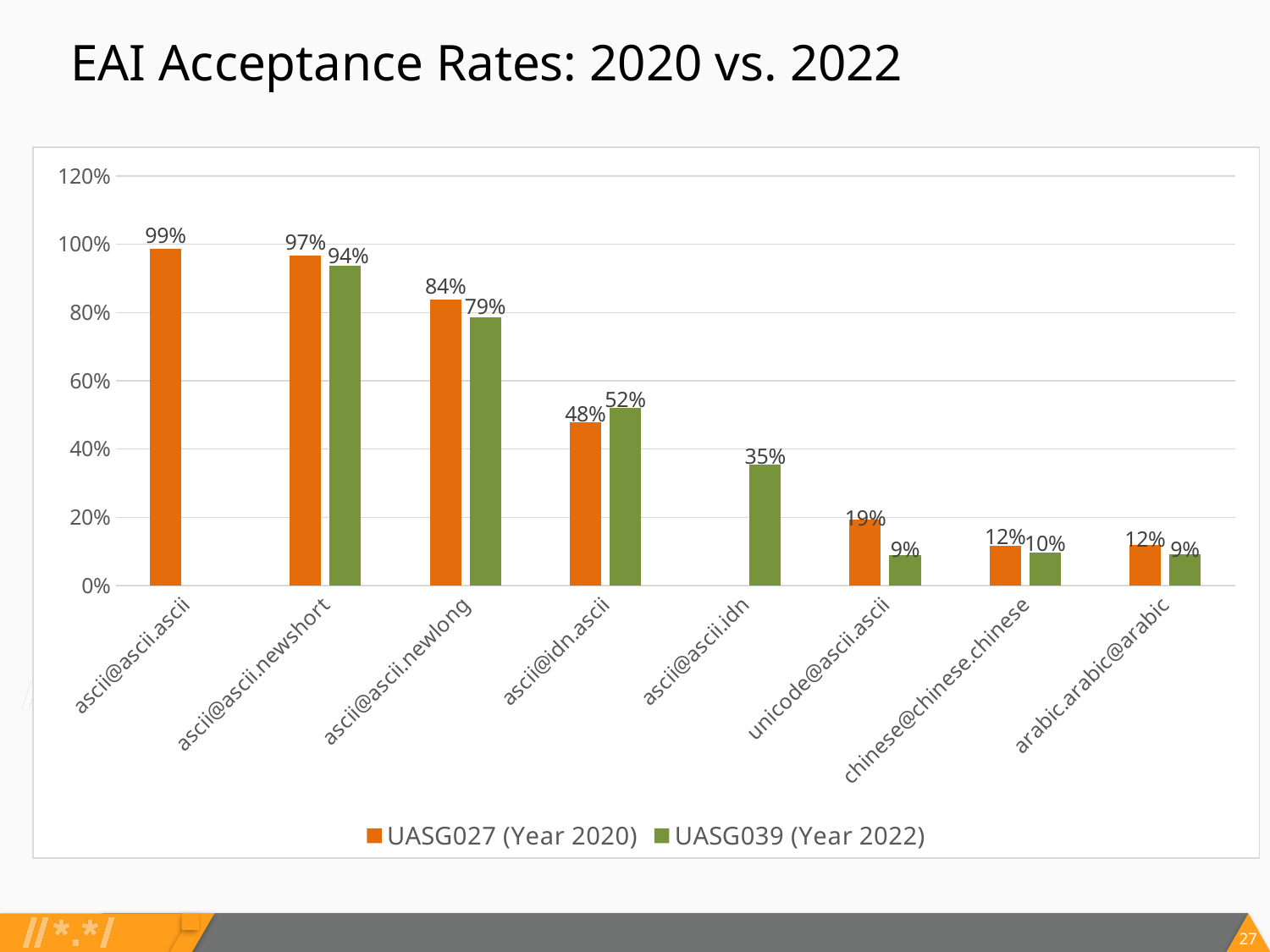
What is the difference between the UASG027 (Year 2020) and UASG039 (Year 2022) values for unicode@ascii.ascii? 10% What is the UASG039 (Year 2022) value for ascii@ascii.idn? 35% What is the title of the slide? EAI Acceptance Rates: 2020 vs. 2022 For ascii@idn.ascii, which series has the larger value, UASG027 (Year 2020) or UASG039 (Year 2022)? UASG039 (Year 2022) How many series does the legend list? 2 Which category has the lowest UASG039 (Year 2022) value? unicode@ascii.ascii and arabic.arabic@arabic (both 9%) How many categories are shown on the x axis? 8 What is the UASG027 (Year 2020) acceptance rate for ascii@ascii.ascii? 99% Is the UASG027 (Year 2020) value for ascii@ascii.newlong greater or less than 80%? greater Which category has the highest UASG027 (Year 2020) value? ascii@ascii.ascii What is the UASG039 (Year 2022) acceptance rate for ascii@ascii.newlong? 79% What kind of chart is shown on the slide? bar chart